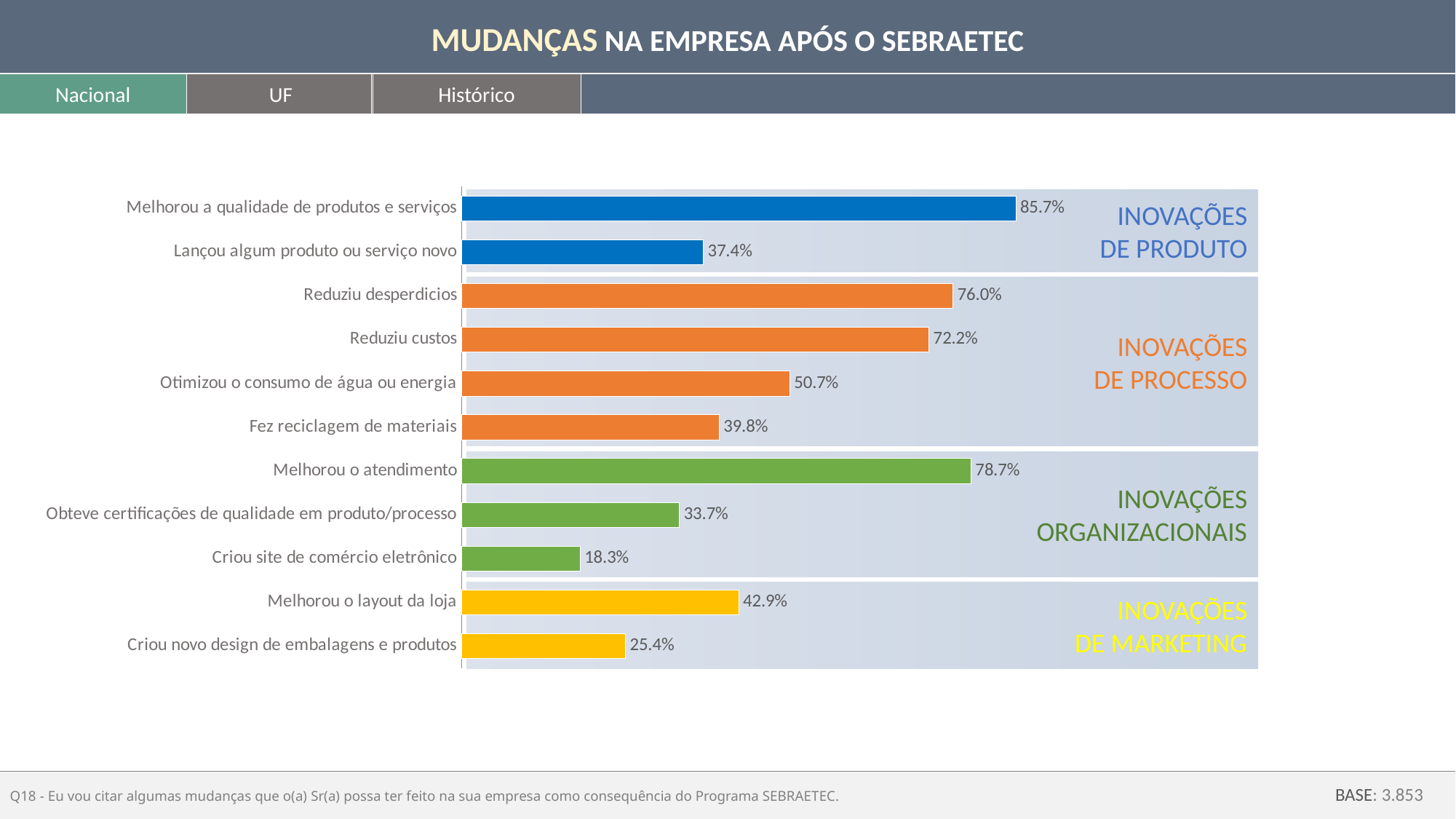
What is the value for "Melhorou o layout da loja"? 42.9% How many categories are shown in the chart? 11 What is the value for "Melhorou a qualidade de produtos e serviços"? 85.7% Which category has the lowest value? Criou site de comércio eletrônico What is the value for "Reduziu custos"? 72.2% Which category has the highest value? Melhorou a qualidade de produtos e serviços What kind of chart is shown on the slide? Bar chart What is the value for "Criou site de comércio eletrônico"? 18.3% Which is larger: "Melhorou o atendimento" or "Reduziu desperdicios"? Melhorou o atendimento What is the difference between "Melhorou o layout da loja" and "Criou novo design de embalagens e produtos"? 17.5% Which group label is shown next to the orange bars? INOVAÇÕES DE PROCESSO What is the difference between "Reduziu desperdicios" and "Reduziu custos"? 3.8%